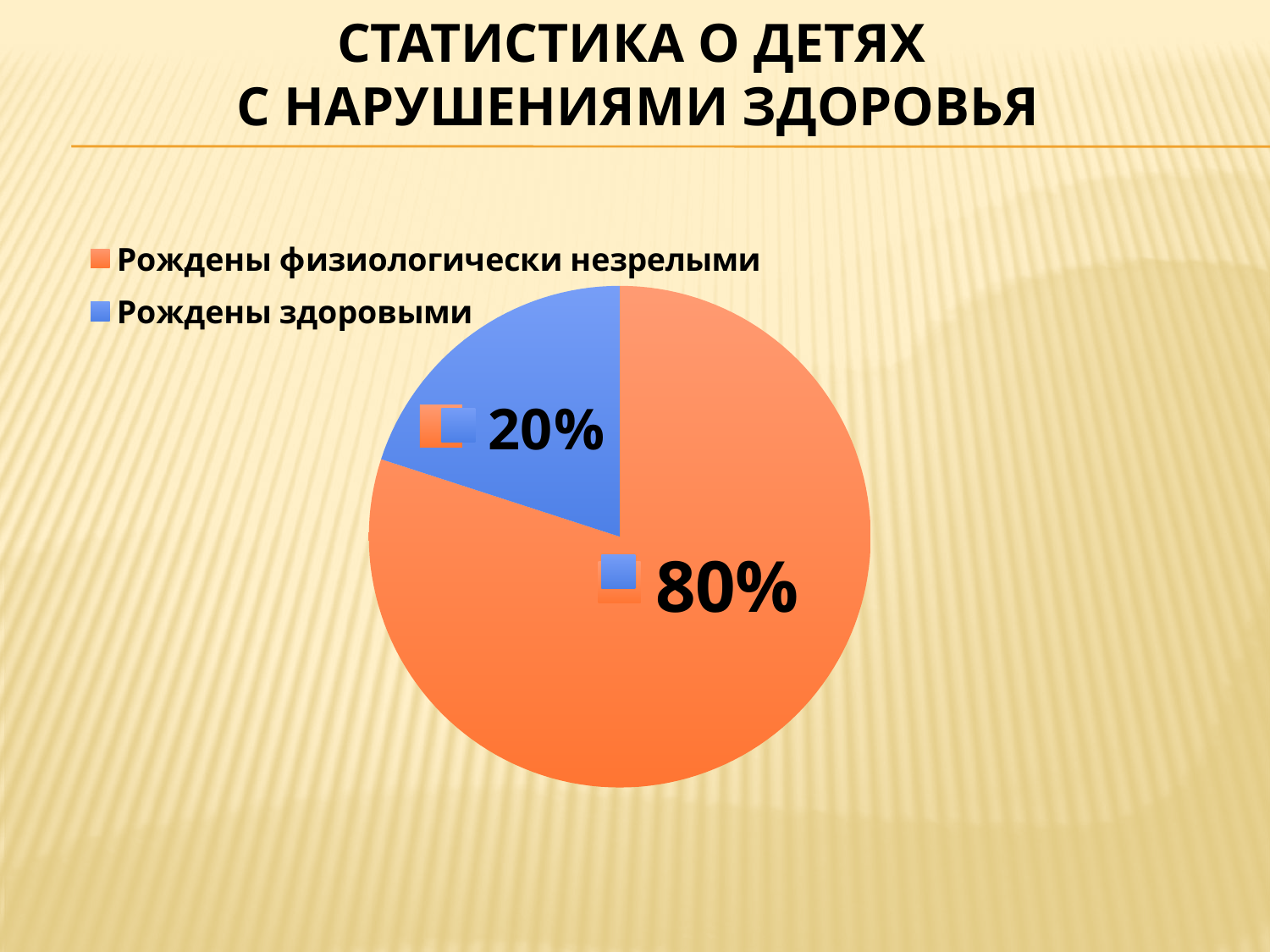
What is the difference in percentage points between the "Рождены физиологически незрелыми" slice and the "Рождены здоровыми" slice? 60 What colour is the slice for "Рождены здоровыми"? blue What kind of chart is shown on the slide? pie chart Which category has the largest slice of the pie? Рождены физиологически незрелыми How many slices does the pie chart have? 2 How many entries does the legend list? 2 Which is larger: the share for "Рождены здоровыми" or the share for "Рождены физиологически незрелыми"? Рождены физиологически незрелыми What share of the pie is labelled "Рождены здоровыми"? 20% What share of the pie is labelled "Рождены физиологически незрелыми"? 80% What colour is the slice for "Рождены физиологически незрелыми"? orange Which category has the smallest slice of the pie? Рождены здоровыми